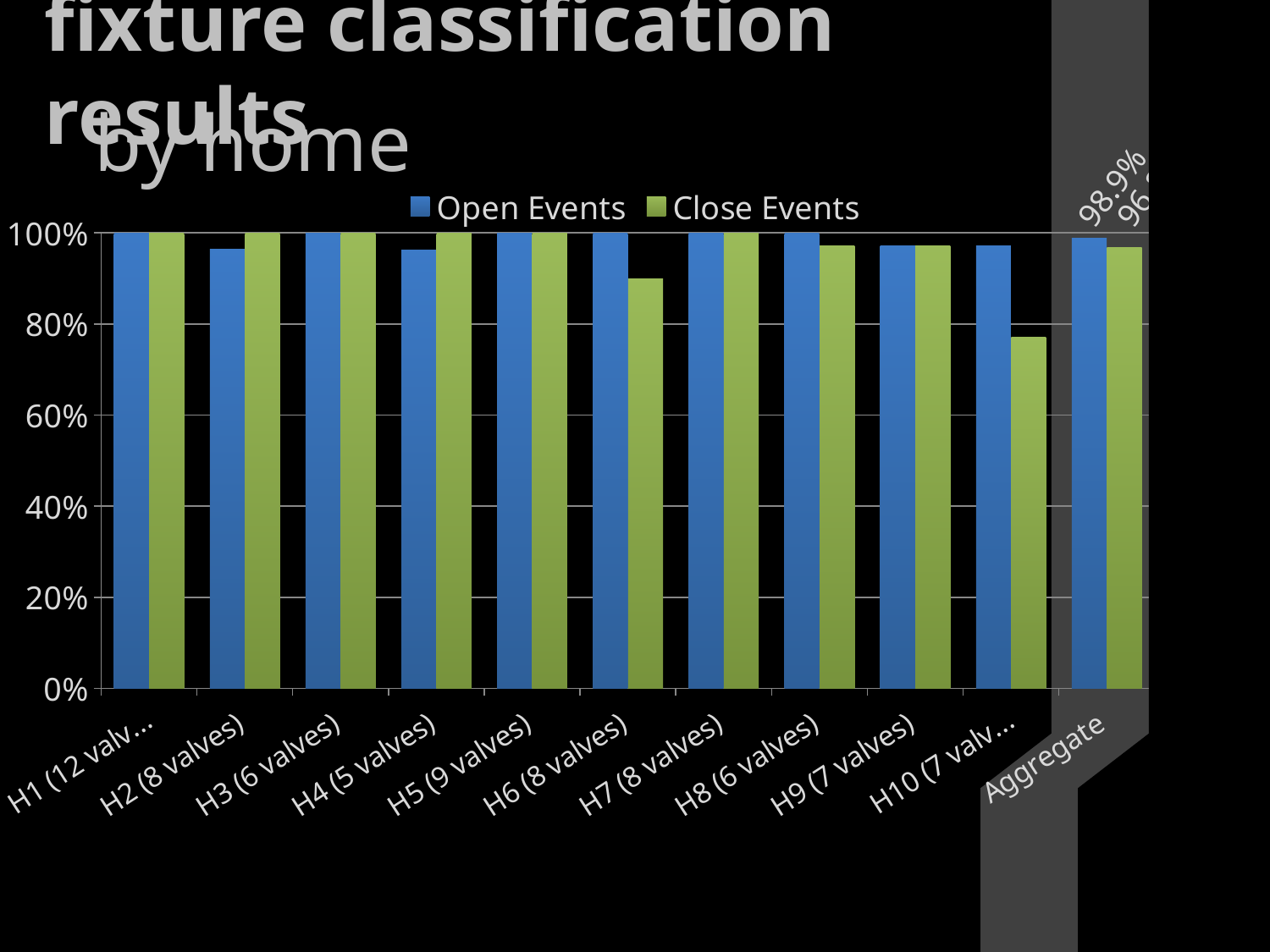
Is the Close Events value for H10 greater or less than 60%? greater Is the Close Events value for H6 (8 valves) greater or less than 80%? greater How many series does the legend list? 2 What kind of chart is shown on the slide? bar chart Is the Close Events value for H10 greater or less than 80%? less How many categories are shown along the x axis? 11 What is the Open Events value for Aggregate? 98.9% For H2 (8 valves), which is larger: Open Events or Close Events? Close Events What is the Open Events value for H3 (6 valves)? 100% Which category has the lowest Close Events value? H10 (7 valv...) For H6 (8 valves), which is larger: Open Events or Close Events? Open Events What colour are the Open Events bars? blue